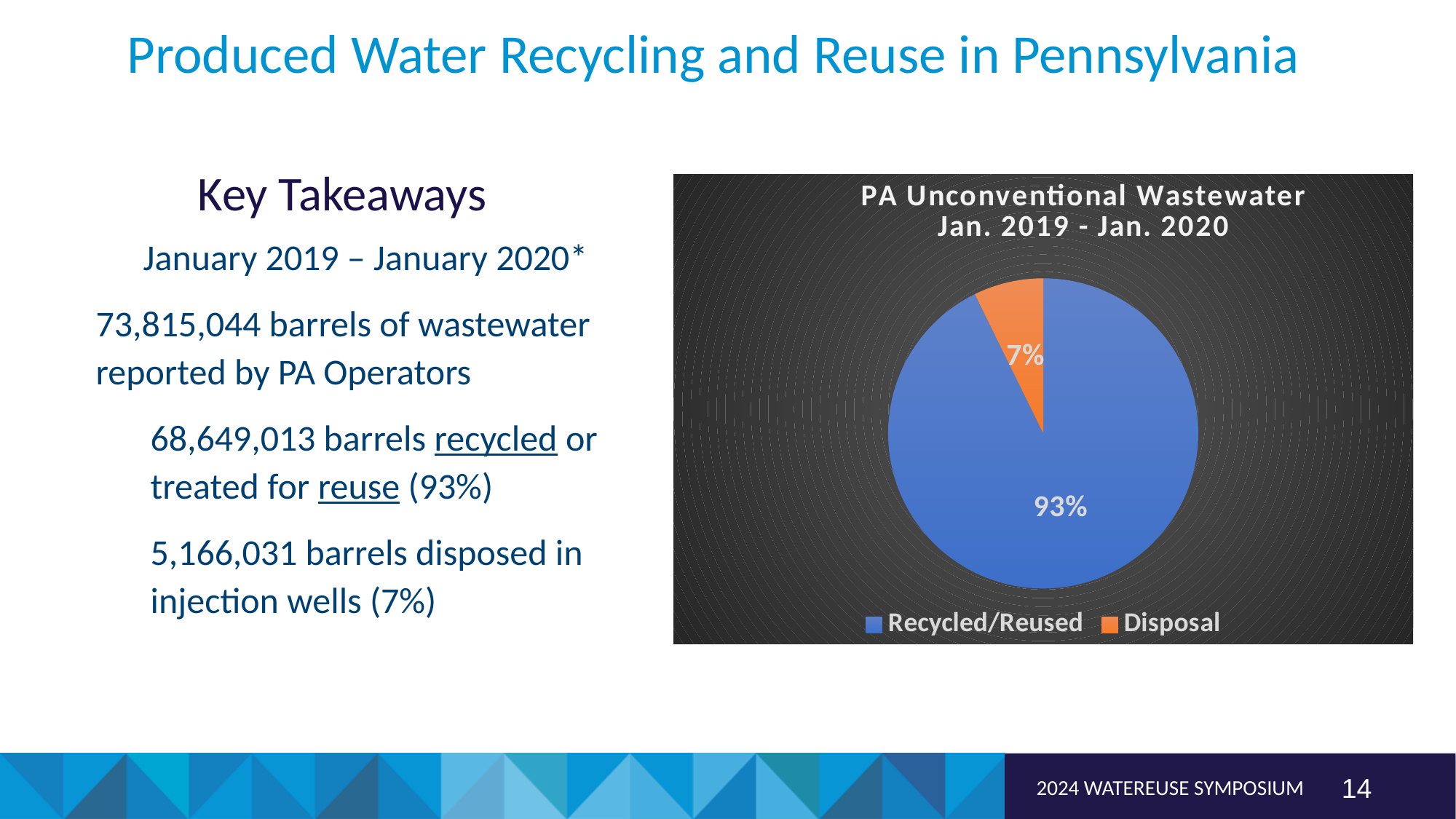
What kind of chart is shown on the slide? pie chart What colour is the Disposal slice in the pie chart? orange Which category has the smallest slice of the pie? Disposal How many categories does the pie chart show? 2 What share of the pie is Recycled/Reused? 93% What is the difference in percentage points between the Recycled/Reused slice and the Disposal slice? 86 Which is larger, the Disposal slice or the Recycled/Reused slice? Recycled/Reused What share of the pie is Disposal? 7% How many entries does the legend list? 2 What is the title of the chart? PA Unconventional Wastewater Jan. 2019 - Jan. 2020 Which category has the largest slice of the pie? Recycled/Reused